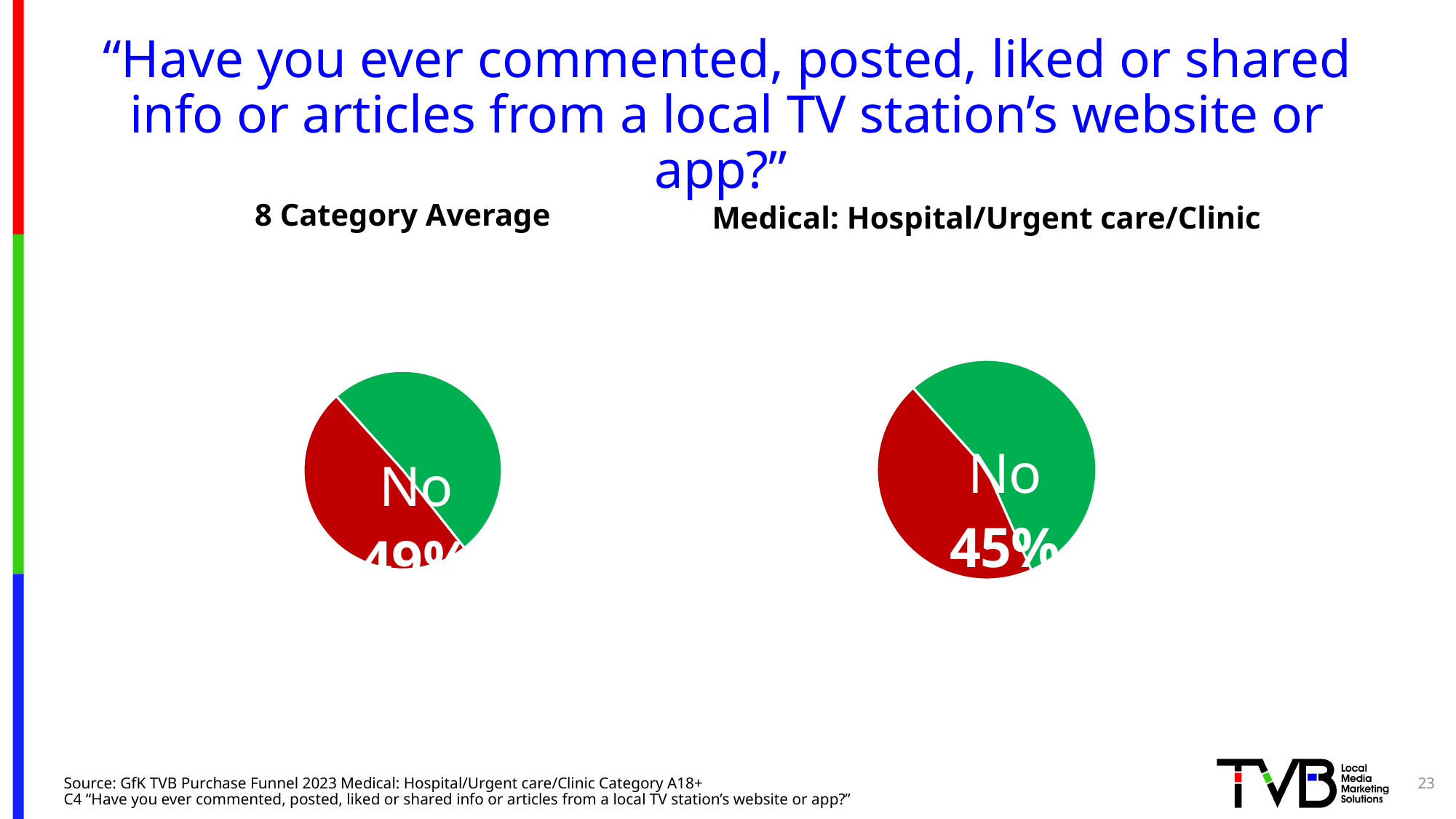
In the Medical: Hospital/Urgent care/Clinic chart, what percentage answered No? 45% What is the title of the pie chart on the right side of the slide? Medical: Hospital/Urgent care/Clinic What is the difference in the No share between the 8 Category Average chart and the Medical: Hospital/Urgent care/Clinic chart? 4 percentage points In the 8 Category Average chart, what percentage answered No? 49% What kind of chart is used on this slide? Pie chart In the Medical: Hospital/Urgent care/Clinic chart, what colour is the No slice? Red Which chart shows a larger No share, 8 Category Average or Medical: Hospital/Urgent care/Clinic? 8 Category Average How many slices does the 8 Category Average pie chart have? 2 How many slices does the Medical: Hospital/Urgent care/Clinic pie chart have? 2 How many pie charts are shown on the slide? 2